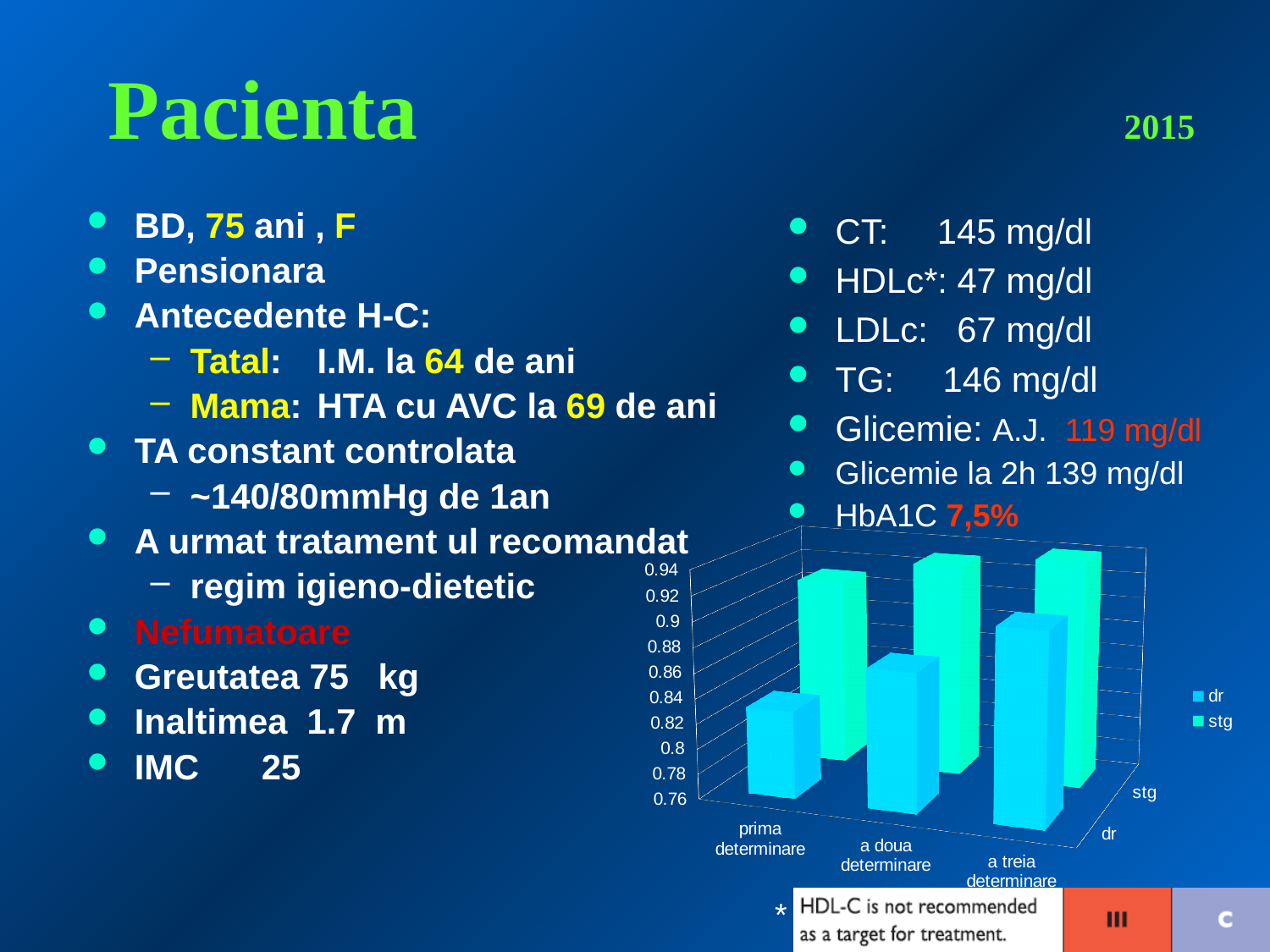
Do the dr series values rise or fall from prima determinare to a treia determinare? rise What kind of chart is shown on the slide? bar chart What is the lowest value shown on the chart's vertical axis? 0.76 Is the dr value for prima determinare greater or less than 0.86? less How many categories are shown on the x axis of the chart? 3 Which is larger for the dr series: prima determinare or a treia determinare? a treia determinare Which is larger for prima determinare: the dr bar or the stg bar? stg How many series does the chart's legend list? 2 What are the two series named in the chart's legend? dr and stg Is the dr value for a treia determinare greater or less than 0.86? greater For the dr series, which category has the highest bar? a treia determinare For the dr series, which category has the lowest bar? prima determinare